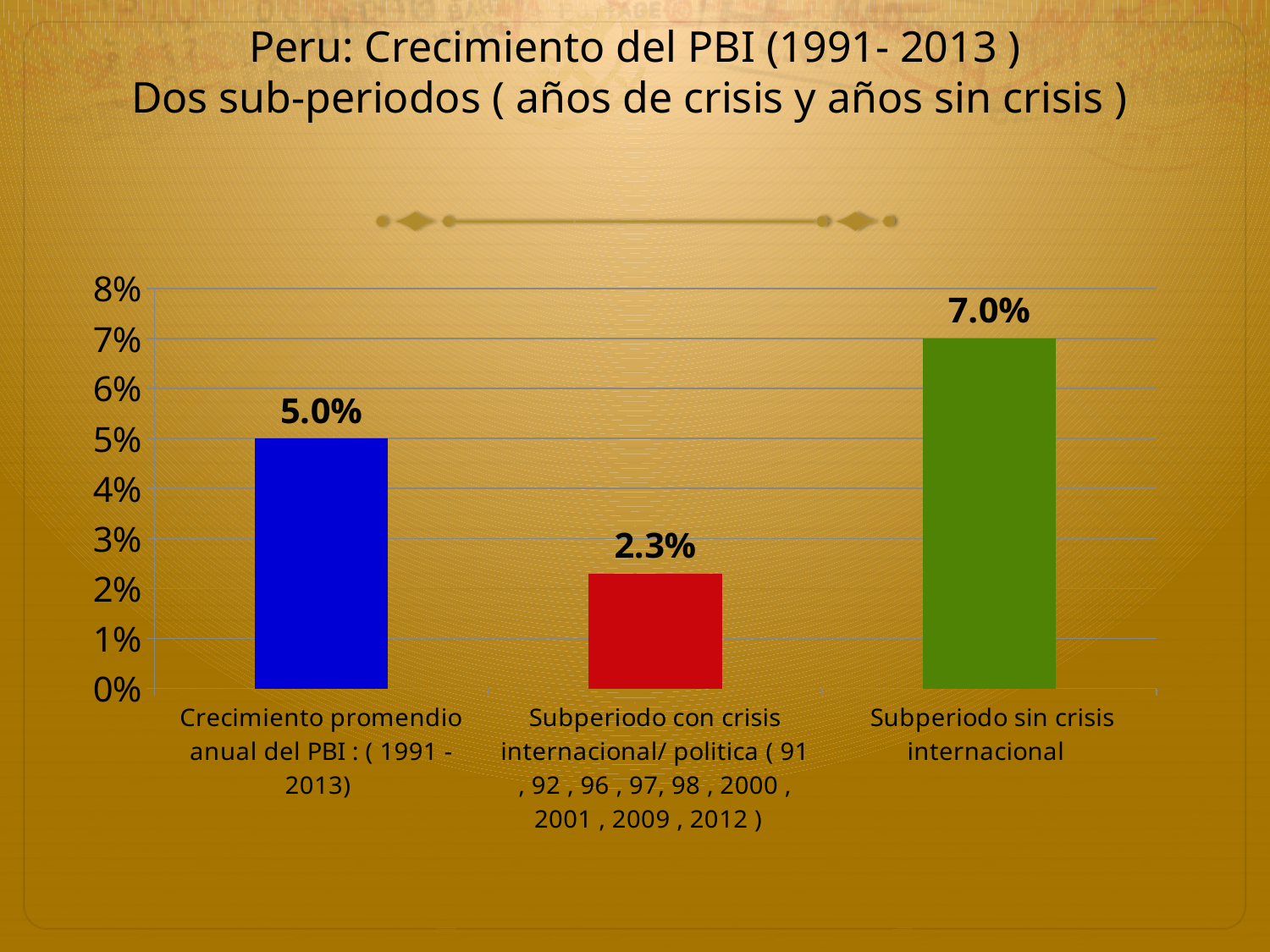
Which category has the lowest value? Subperiodo con crisis internacional/ politica What is the value for 'Crecimiento promendio anual del PBI : ( 1991 - 2013)'? 5.0% Is the value for 'Subperiodo con crisis internacional/ politica' greater or less than 3%? less Which category has the highest value? Subperiodo sin crisis internacional What is the value for 'Subperiodo con crisis internacional/ politica'? 2.3% What kind of chart is shown on the slide? bar chart What is the value for 'Subperiodo sin crisis internacional'? 7.0% What is the difference between the value for 'Subperiodo sin crisis internacional' and the value for 'Subperiodo con crisis internacional/ politica'? 4.7% How many categories are shown in the chart? 3 What is the difference between the value for 'Subperiodo sin crisis internacional' and the average annual growth for 1991-2013? 2.0% What colour is the bar for 'Subperiodo sin crisis internacional'? green Which is larger: the value for 'Crecimiento promendio anual del PBI' or the value for 'Subperiodo con crisis internacional/ politica'? Crecimiento promendio anual del PBI